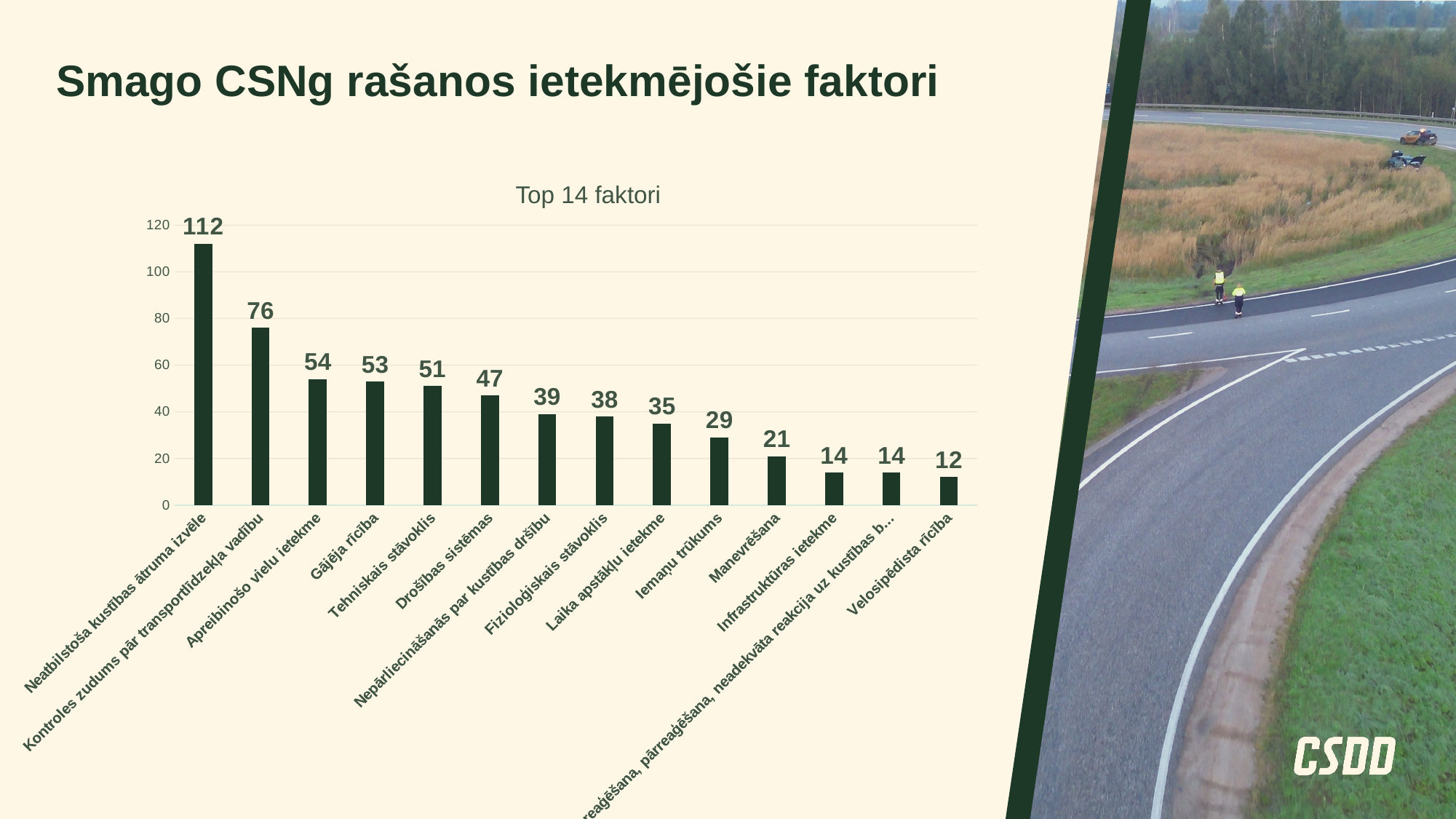
Which category has the lowest value? Velosipēdista rīcība Do the values rise or fall from left to right along the x axis? Fall What kind of chart is shown on the slide? Bar chart Which category has the highest value? Neatbilstoša kustības ātruma izvēle What is the value for Manevrēšana? 21 What is the title of the chart? Top 14 faktori What is the value for Gājēja rīcība? 53 Which is larger, Drošības sistēmas or Laika apstākļu ietekme? Drošības sistēmas What is the value for Neatbilstoša kustības ātruma izvēle? 112 What is the difference between Kontroles zudums pār transportlīdzekļa vadību and Apreibinošo vielu ietekme? 22 How many categories are shown in the chart? 14 Is the value for Tehniskais stāvoklis greater or less than 40? greater